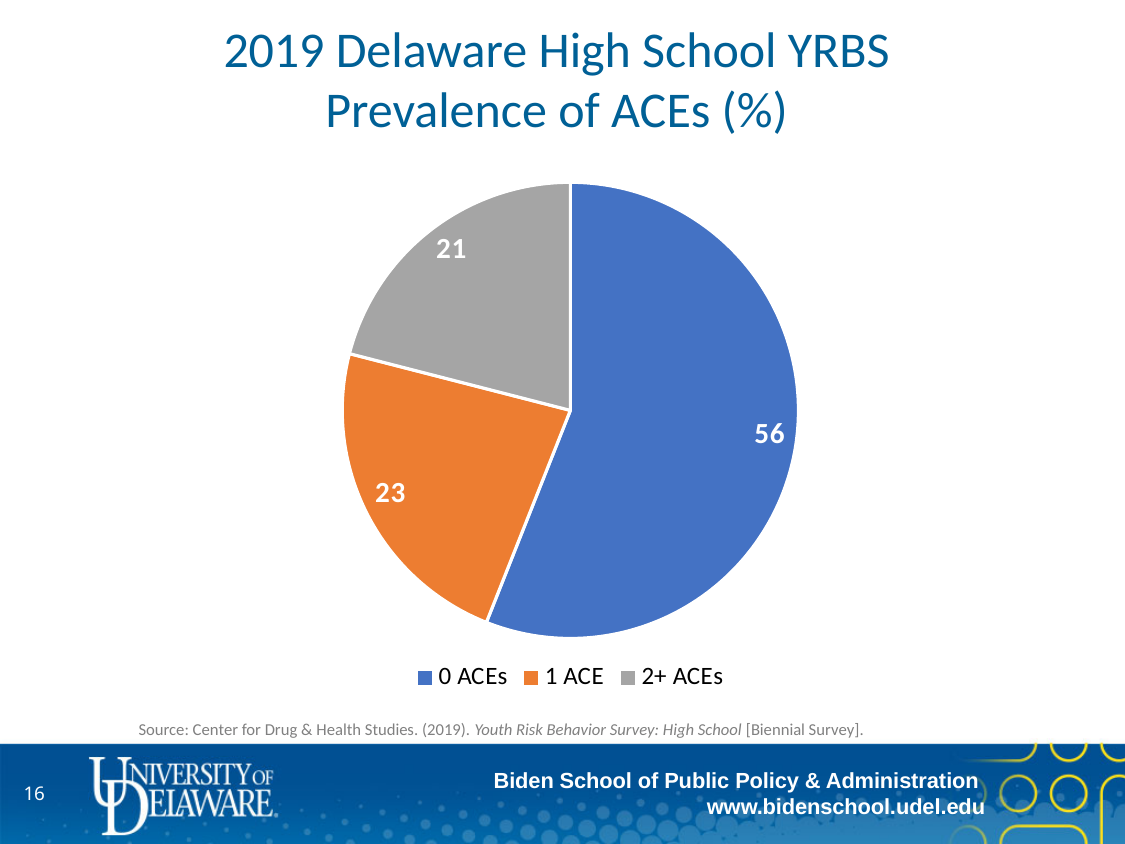
What is the value for 1 ACE? 23 Which category has the smallest slice? 2+ ACEs Which category has the largest slice? 0 ACEs How many categories does the pie chart have? 3 What colour is the slice for 1 ACE? orange What is the value for 0 ACEs? 56 What is the title of the chart? 2019 Delaware High School YRBS Prevalence of ACEs (%) What is the difference between the values for 0 ACEs and 1 ACE? 33 Which is larger, the value for 0 ACEs or the value for 2+ ACEs? 0 ACEs What is the difference between the values for 1 ACE and 2+ ACEs? 2 What is the value for 2+ ACEs? 21 What kind of chart is shown on the slide? pie chart